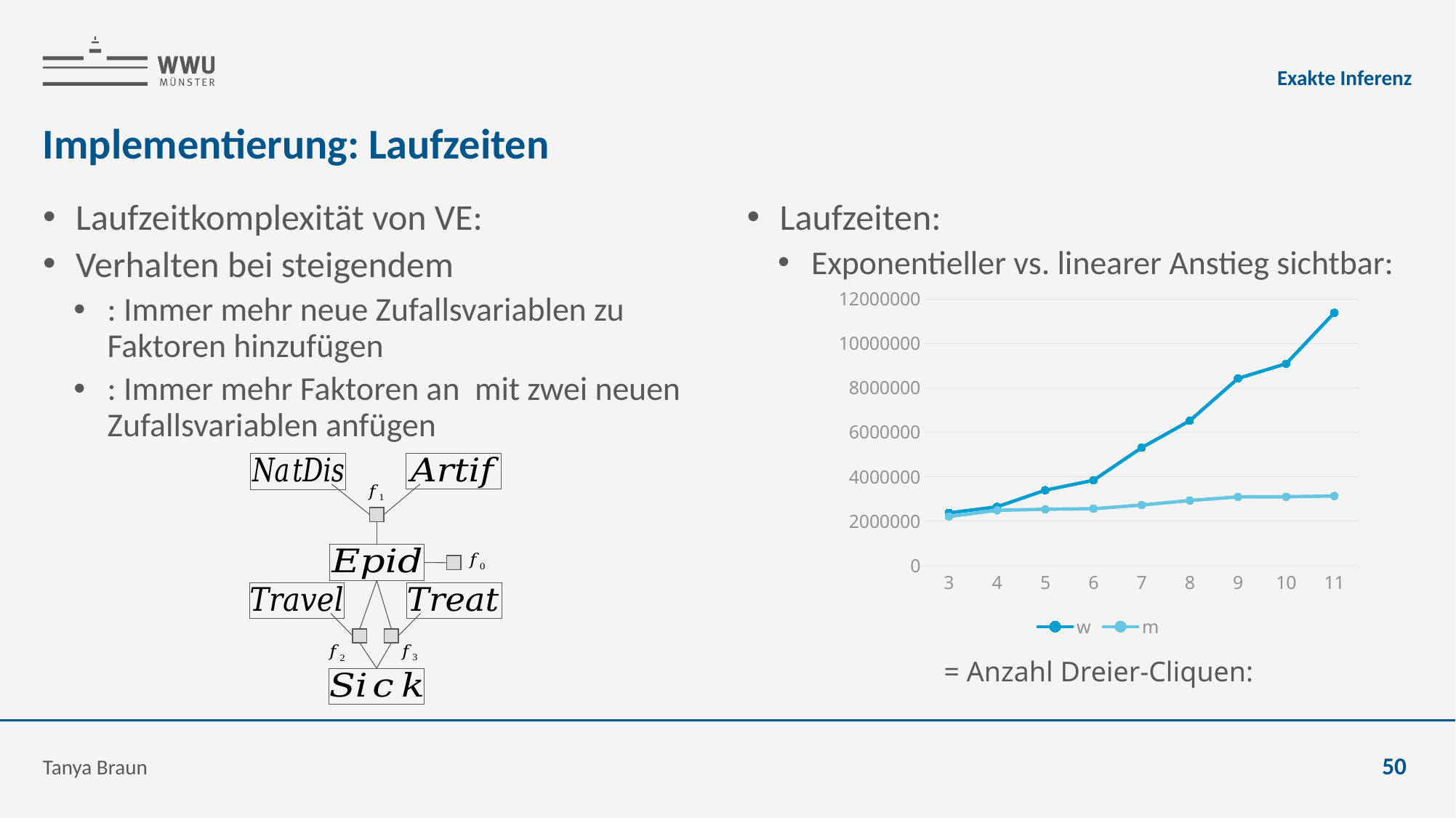
At x = 11, which series has the larger value, w or m? w At which x value does series w have its lowest value? 3 Is the value of series w at x = 5 greater or less than 4000000? less Is the value of series w at x = 11 greater or less than 10000000? greater Is the value of series m at x = 11 greater or less than 4000000? less How many series does the chart legend list? 2 How many x-axis points are plotted for each series in the chart? 9 What are the names of the two series in the chart legend? w and m At which x value does series w reach its highest value? 11 What kind of chart is shown on the slide? line chart Do the values of series w rise or fall as x increases from 3 to 11? rise